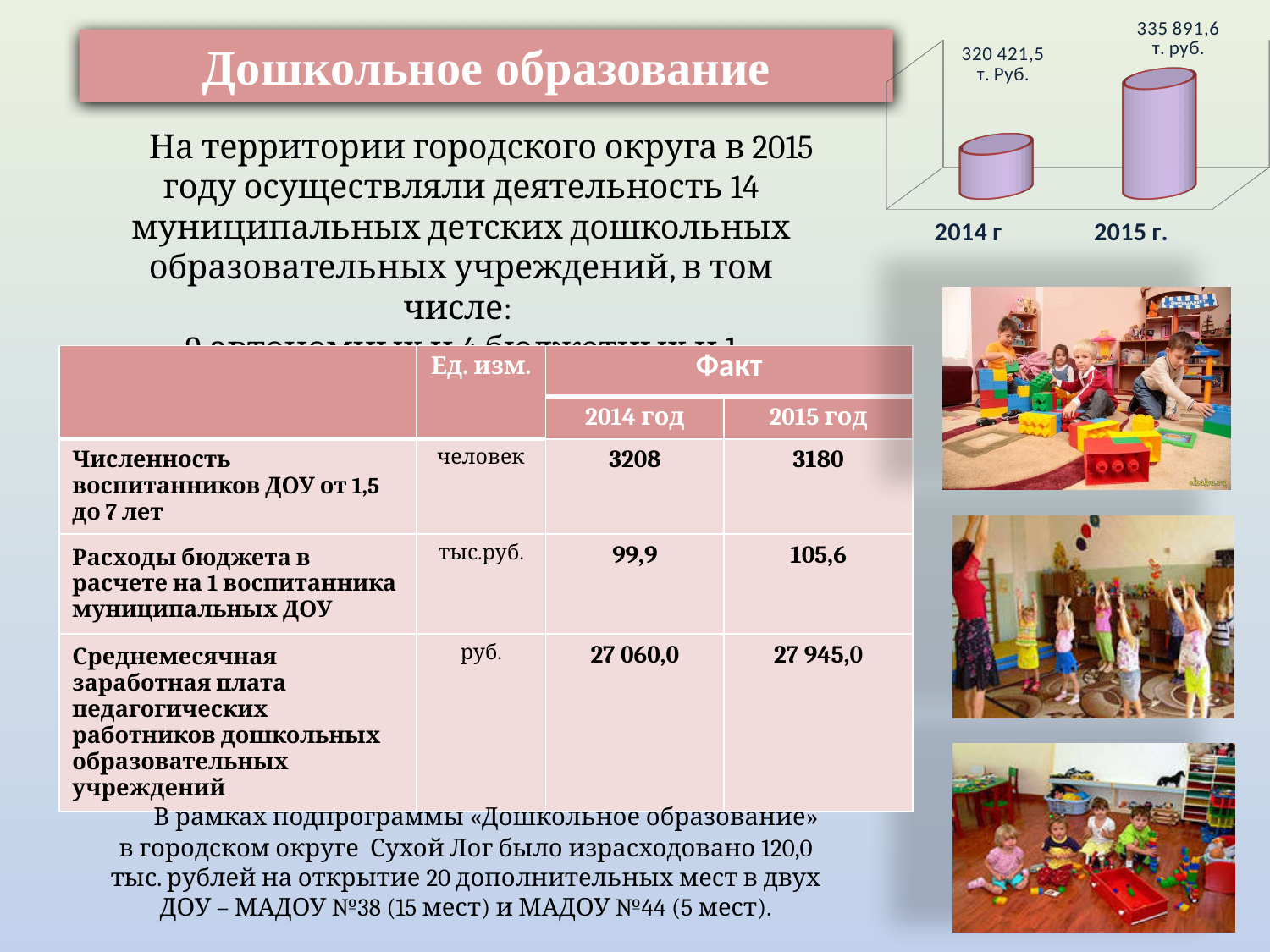
In the chart at the top right, which year has the higher value? 2015 г. What value is shown for 2015 г. in the chart at the top right of the slide? 335 891,6 т. руб. What kind of chart is shown at the top right of the slide? bar chart In the chart at the top right, do the values rise or fall from 2014 г to 2015 г.? rise In the chart at the top right, which year has the lower value? 2014 г What colour are the bars in the chart at the top right of the slide? purple In the chart at the top right, is the value for 2015 г. larger or smaller than the value for 2014 г? larger What value is shown for 2014 г in the chart at the top right of the slide? 320 421,5 т. Руб. How many categories (years) are plotted in the chart at the top right of the slide? 2 In the chart at the top right, by how much does the 2015 г. value exceed the 2014 г value? 15 470,1 What unit is shown on the data labels of the chart at the top right? т. руб.